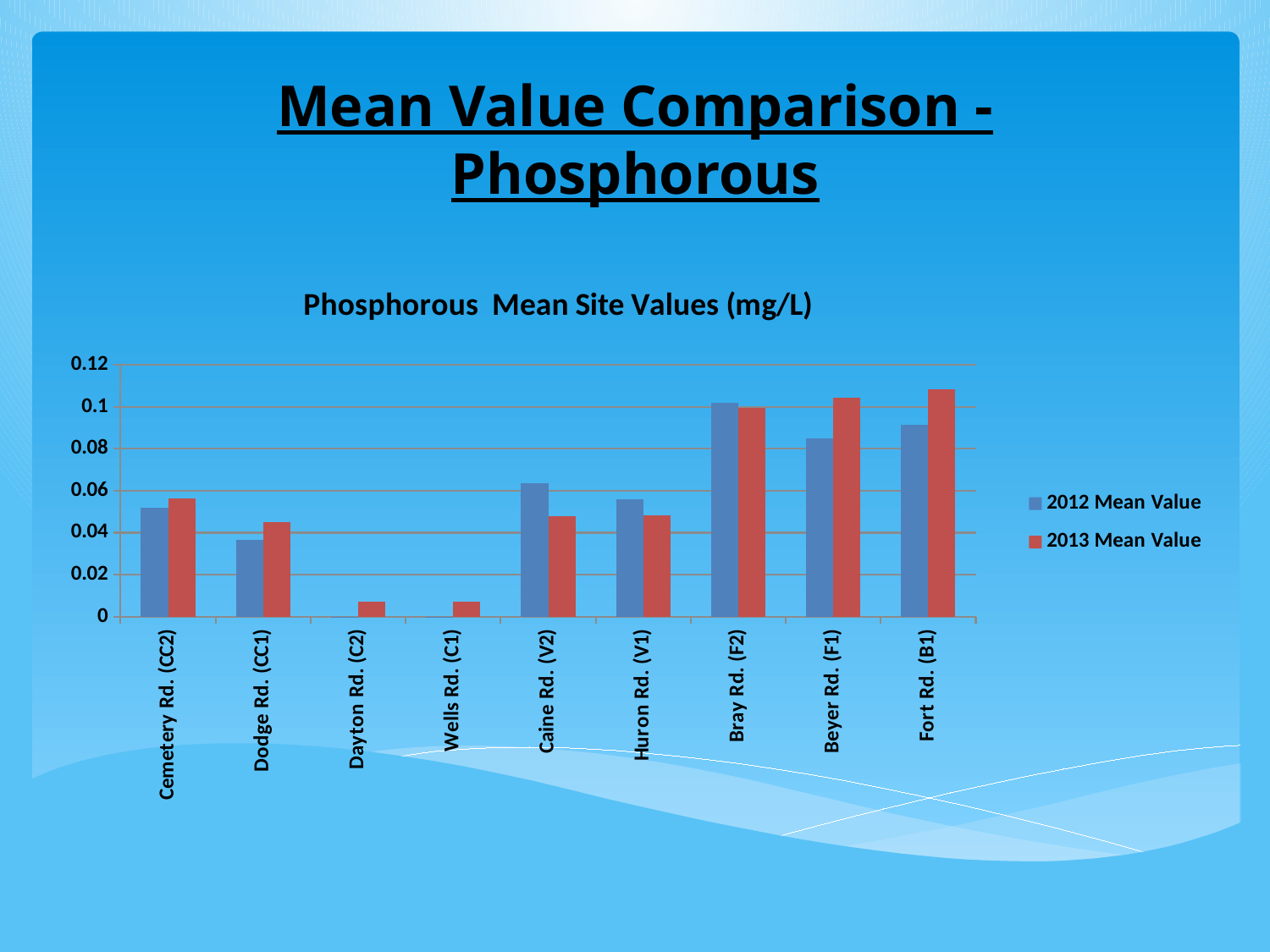
Is the 2012 Mean Value for Beyer Rd. (F1) greater or less than 0.08? greater Is the 2013 Mean Value for Dayton Rd. (C2) greater or less than 0.02? less How many sites are shown along the x axis? 9 Is the 2013 Mean Value for Beyer Rd. (F1) greater or less than 0.1? greater Which site has the highest 2013 Mean Value? Fort Rd. (B1) What kind of chart is shown on the slide? bar chart Which site has the highest 2012 Mean Value? Bray Rd. (F2) How many series does the legend list? 2 What is the title of the chart? Phosphorous Mean Site Values (mg/L) For Caine Rd. (V2), which is larger: the 2012 Mean Value or the 2013 Mean Value? 2012 Mean Value For Beyer Rd. (F1), which is larger: the 2012 Mean Value or the 2013 Mean Value? 2013 Mean Value